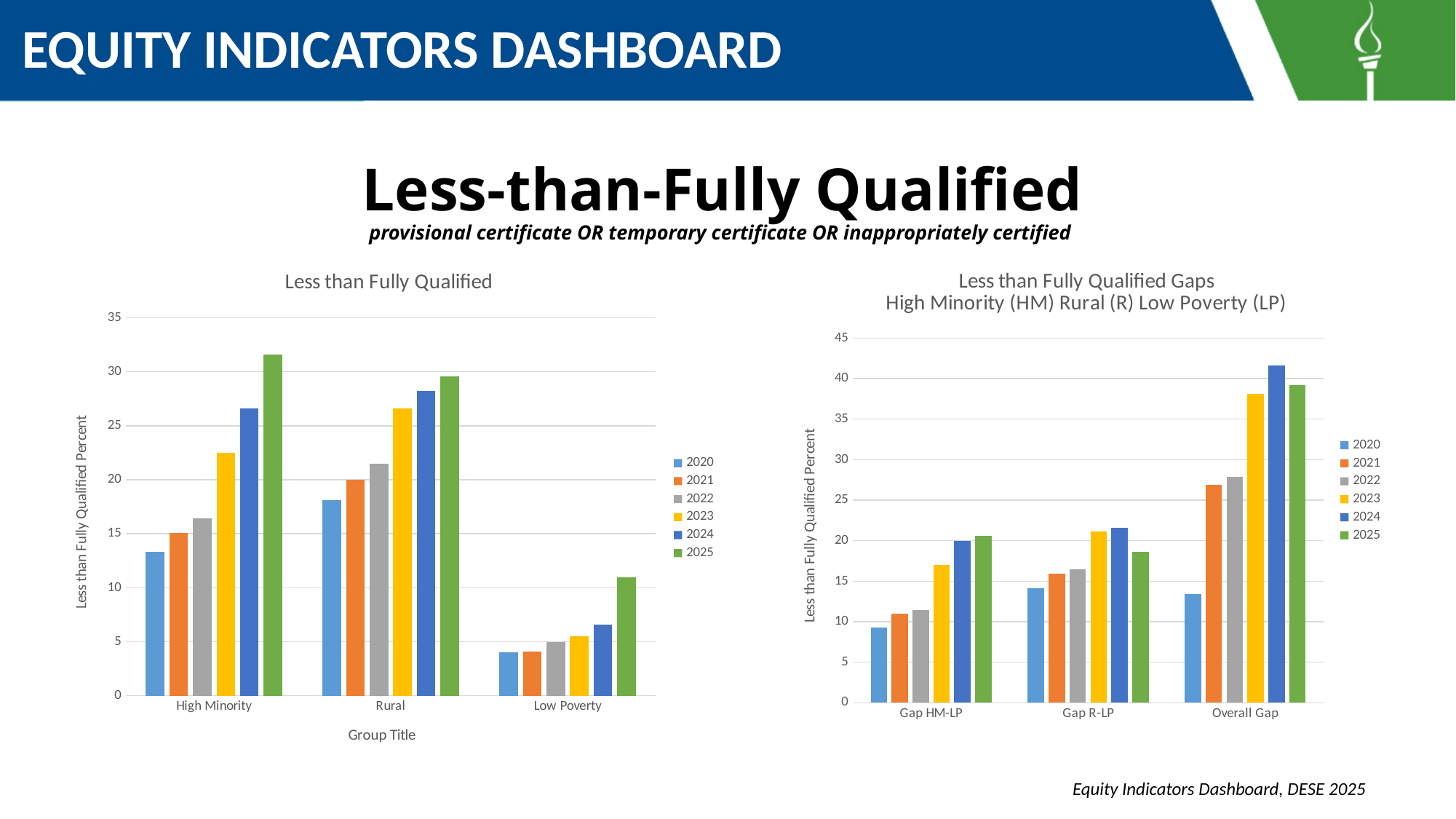
In the 'Less than Fully Qualified' chart on the left, is the 2020 value for Low Poverty greater or less than 5? less In the 'Less than Fully Qualified Gaps' chart on the right, which category has the highest 2024 value? Overall Gap In the 'Less than Fully Qualified Gaps' chart on the right, is the 2024 value for Overall Gap greater or less than 40? greater In the 'Less than Fully Qualified' chart on the left, is the 2025 value for High Minority greater or less than 30? greater In the 'Less than Fully Qualified Gaps' chart on the right, which is larger for Gap R-LP: the 2024 value or the 2025 value? 2024 In the 'Less than Fully Qualified' chart on the left, which group has the highest 2025 value? High Minority What kind of chart is the 'Less than Fully Qualified' chart on the left? bar chart In the 'Less than Fully Qualified' chart on the left, do the High Minority values rise or fall from 2020 to 2025? rise In the 'Less than Fully Qualified' chart on the left, how many groups are shown on the x axis? 3 What is the x-axis title of the 'Less than Fully Qualified' chart on the left? Group Title In the 'Less than Fully Qualified' chart on the left, how many series does the legend list? 6